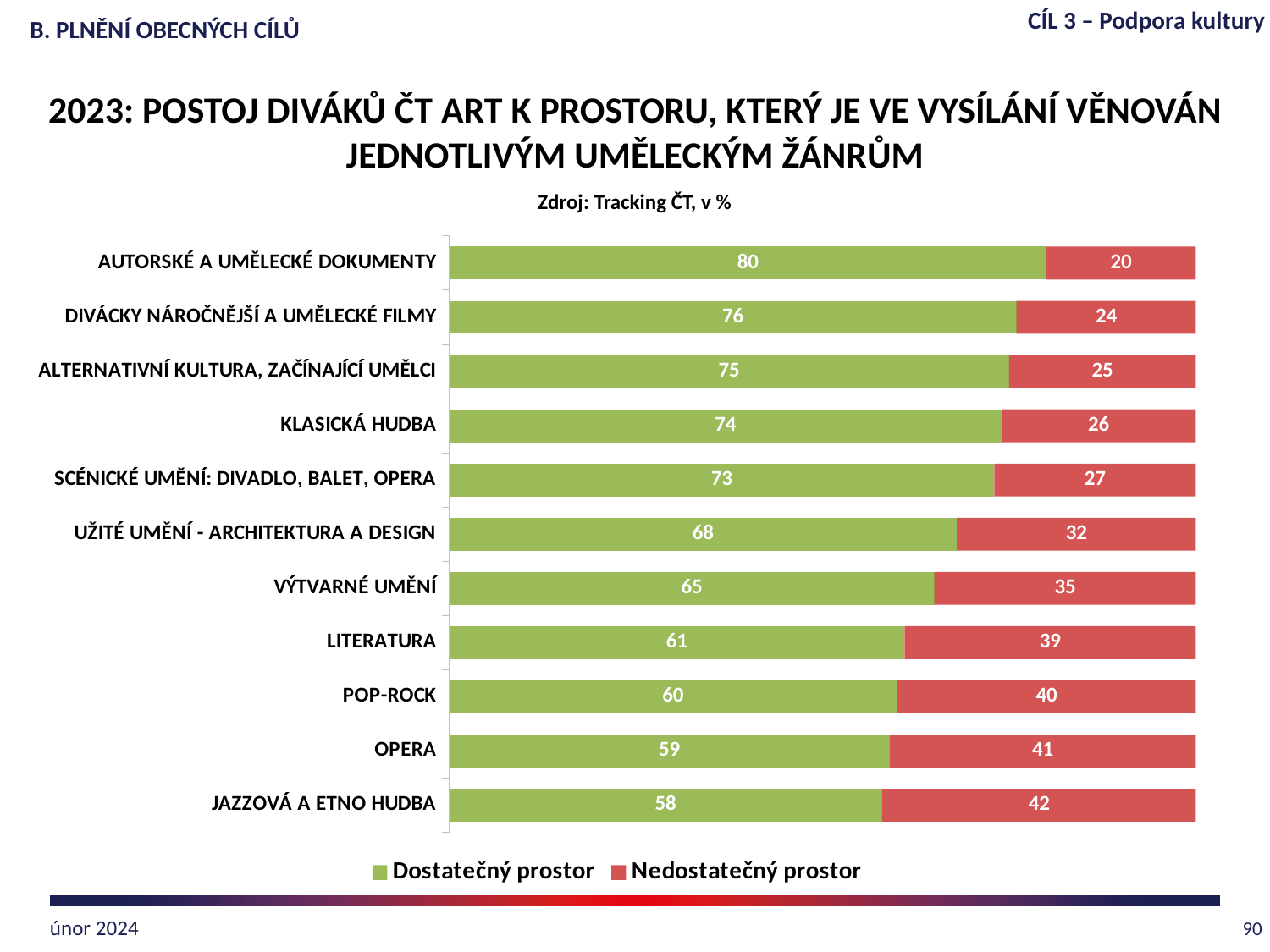
What is the value of "Dostatečný prostor" for KLASICKÁ HUDBA? 74 Which category has the lowest value for "Dostatečný prostor"? JAZZOVÁ A ETNO HUDBA Which is larger: the "Nedostatečný prostor" value for VÝTVARNÉ UMĚNÍ or for OPERA? OPERA Which colour represents "Nedostatečný prostor" in the chart? Red What kind of chart is shown on the slide? Stacked bar chart What is the difference between the "Dostatečný prostor" values for AUTORSKÉ A UMĚLECKÉ DOKUMENTY and POP-ROCK? 20 How many categories are shown in the chart? 11 How many series does the legend list? 2 What is the total of the stacked bar for SCÉNICKÉ UMĚNÍ: DIVADLO, BALET, OPERA? 100 What is the value of "Nedostatečný prostor" for LITERATURA? 39 Which category has the highest value for "Dostatečný prostor"? AUTORSKÉ A UMĚLECKÉ DOKUMENTY Which category has the highest value for "Nedostatečný prostor"? JAZZOVÁ A ETNO HUDBA